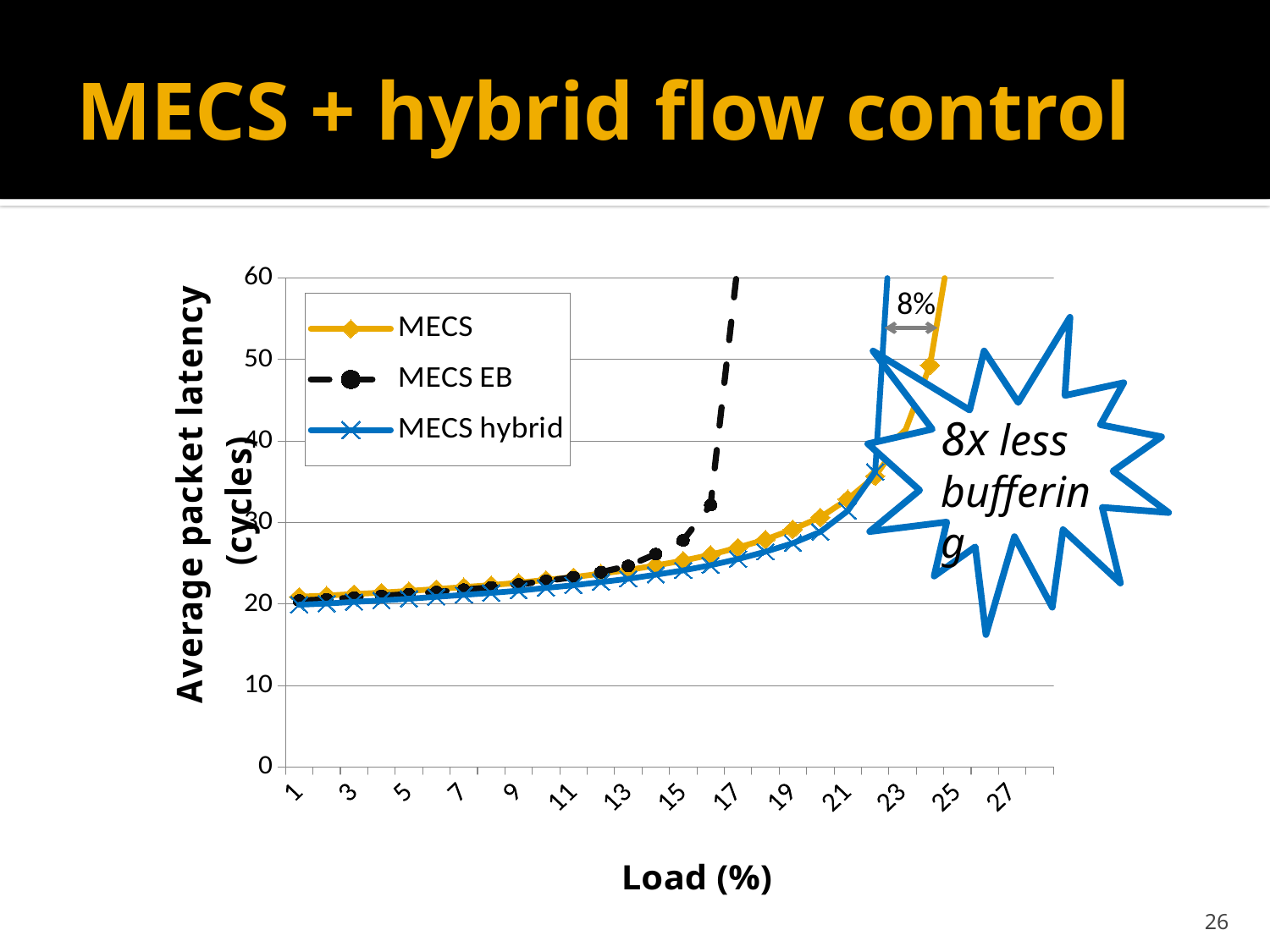
At a load of 15%, which series has the higher average packet latency, MECS EB or MECS hybrid? MECS EB What are the three series named in the legend? MECS, MECS EB, MECS hybrid Is the average packet latency for MECS hybrid at a load of 19% greater or less than 30 cycles? less What is the title of the x axis? Load (%) What is the highest load value labeled on the x axis? 27 Do the average packet latency values rise or fall as load increases along the x axis? rise Which series reaches 60 cycles at the highest load? MECS How many series does the legend list? 3 What kind of chart is shown on the slide? line chart Which series reaches 60 cycles at the lowest load? MECS EB Is the average packet latency for MECS EB at a load of 13% greater or less than 30 cycles? less